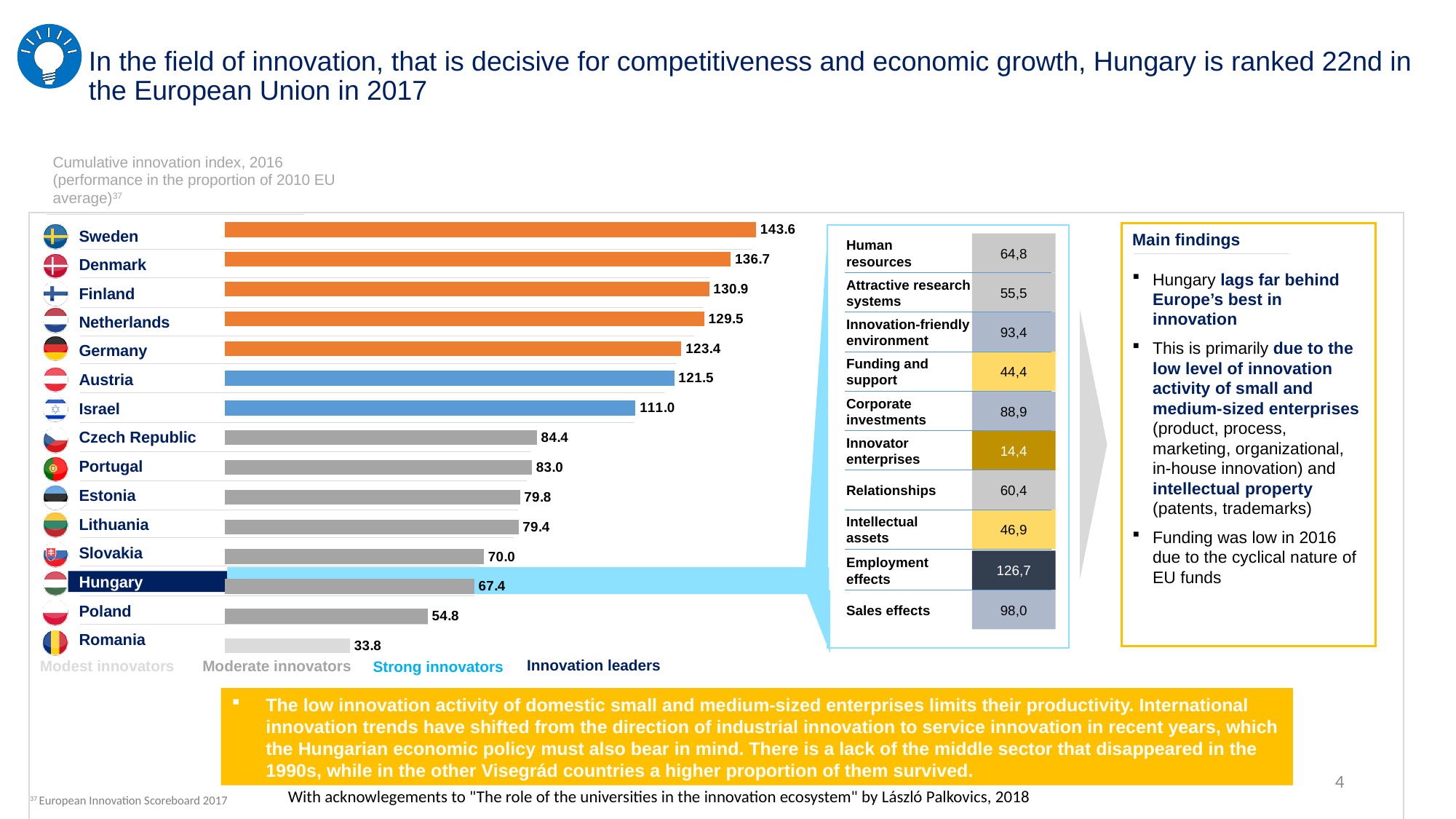
How many countries are shown in the bar chart? 15 What is the value shown for Czech Republic? 84.4 Which has a higher value, Poland or Hungary? Hungary What is the difference between the values for Sweden and Hungary? 76.2 What is the value shown for Sweden in the bar chart? 143.6 What is the difference between the values for Slovakia and Hungary? 2.6 What is the cumulative innovation index value shown for Hungary? 67.4 What kind of chart is used to show the cumulative innovation index by country? Bar chart Which has a higher value, Austria or Israel? Austria Which country has the highest value in the bar chart? Sweden Which country has the lowest value in the bar chart? Romania Which innovator group label is shown in light blue below the bar chart? Strong innovators